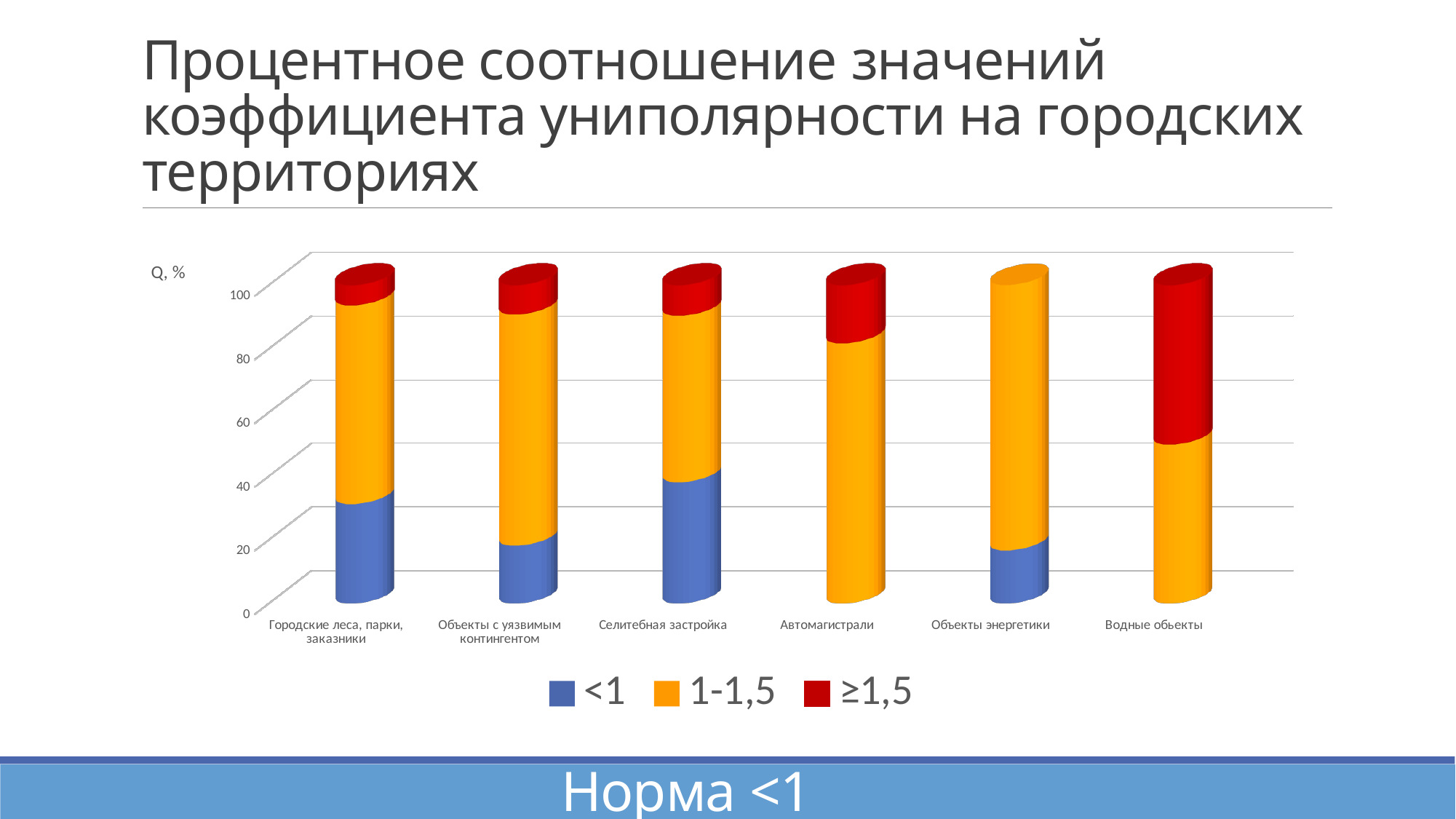
Is the <1 value for Селитебная застройка greater or less than 20? greater Which category has no ≥1,5 segment at all? Объекты энергетики Which category has the largest <1 segment? Селитебная застройка Is the ≥1,5 value for Водные объекты greater or less than 20? greater What are the three series listed in the chart legend? <1, 1-1,5, ≥1,5 How many series does the chart legend list? 3 Is the ≥1,5 value for Городские леса, парки, заказники greater or less than 20? less What kind of chart is shown on the slide? Stacked bar chart Which category has the largest ≥1,5 segment? Водные объекты What is the label on the vertical axis of the chart? Q, % Which is larger: the <1 value for Селитебная застройка or the <1 value for Объекты с уязвимым контингентом? Селитебная застройка How many categories are shown on the x axis of the chart? 6